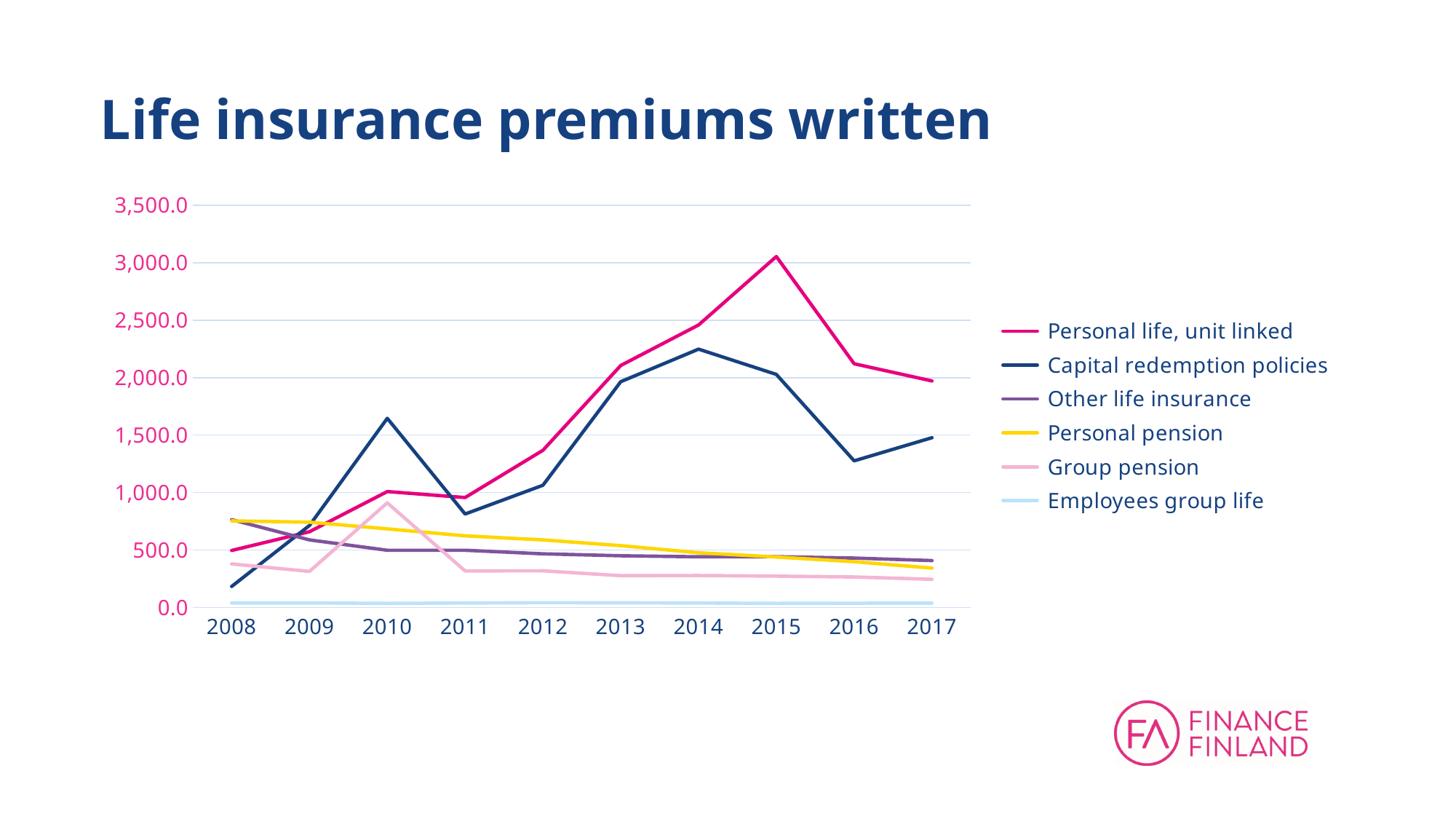
Does the Personal pension series rise or fall from 2008 to 2017? Fall Is the value for Capital redemption policies in 2010 greater or less than 1,500? greater How many years are shown on the x axis? 10 How many series does the legend list? 6 Is the value for Capital redemption policies in 2008 greater or less than 500? less Is the value for Personal life, unit linked in 2015 greater or less than 3,000? greater Which series has the lowest values across all years? Employees group life In 2010, which is higher: Personal life, unit linked or Capital redemption policies? Capital redemption policies In which year does the Capital redemption policies series reach its highest value? 2014 In 2017, which is higher: Personal life, unit linked or Capital redemption policies? Personal life, unit linked What kind of chart is shown on the slide? Line chart In which year does the Personal life, unit linked series reach its highest value? 2015